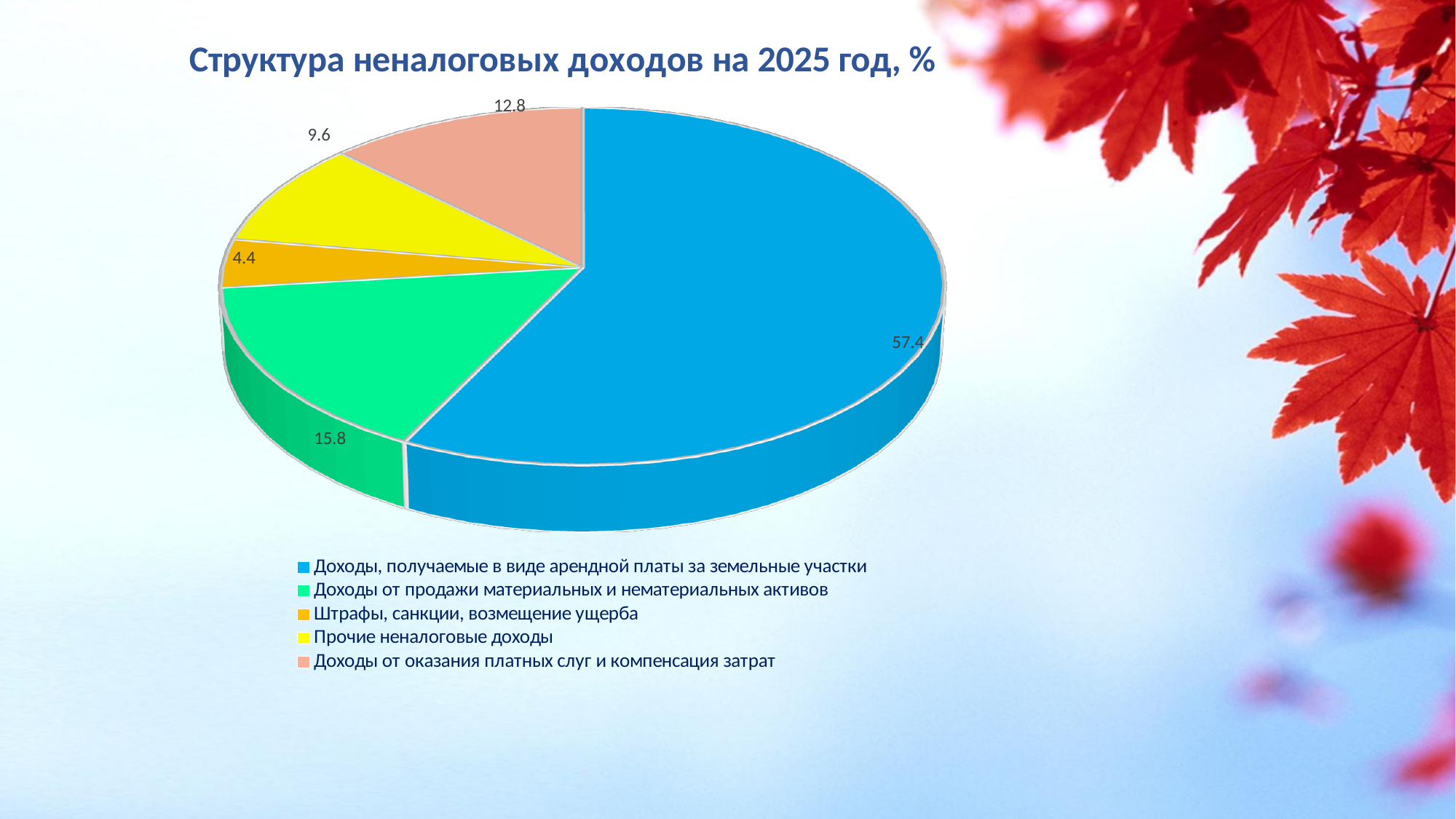
Which category has the smallest share of the pie? Штрафы, санкции, возмещение ущерба What is the title of the chart? Структура неналоговых доходов на 2025 год, % What is the value for "Штрафы, санкции, возмещение ущерба"? 4.4 Which category has the largest share of the pie? Доходы, получаемые в виде арендной платы за земельные участки How many categories does the pie chart have? 5 What is the value for "Доходы от оказания платных слуг и компенсация затрат"? 12.8 What is the value for "Доходы, получаемые в виде арендной платы за земельные участки"? 57.4 What is the value for "Прочие неналоговые доходы"? 9.6 Which is larger: the value for "Прочие неналоговые доходы" or the value for "Доходы от оказания платных слуг и компенсация затрат"? Доходы от оказания платных слуг и компенсация затрат What is the difference between the values for "Доходы от продажи материальных и нематериальных активов" and "Доходы от оказания платных слуг и компенсация затрат"? 3 What kind of chart is shown on the slide? Pie chart What is the value for "Доходы от продажи материальных и нематериальных активов"? 15.8